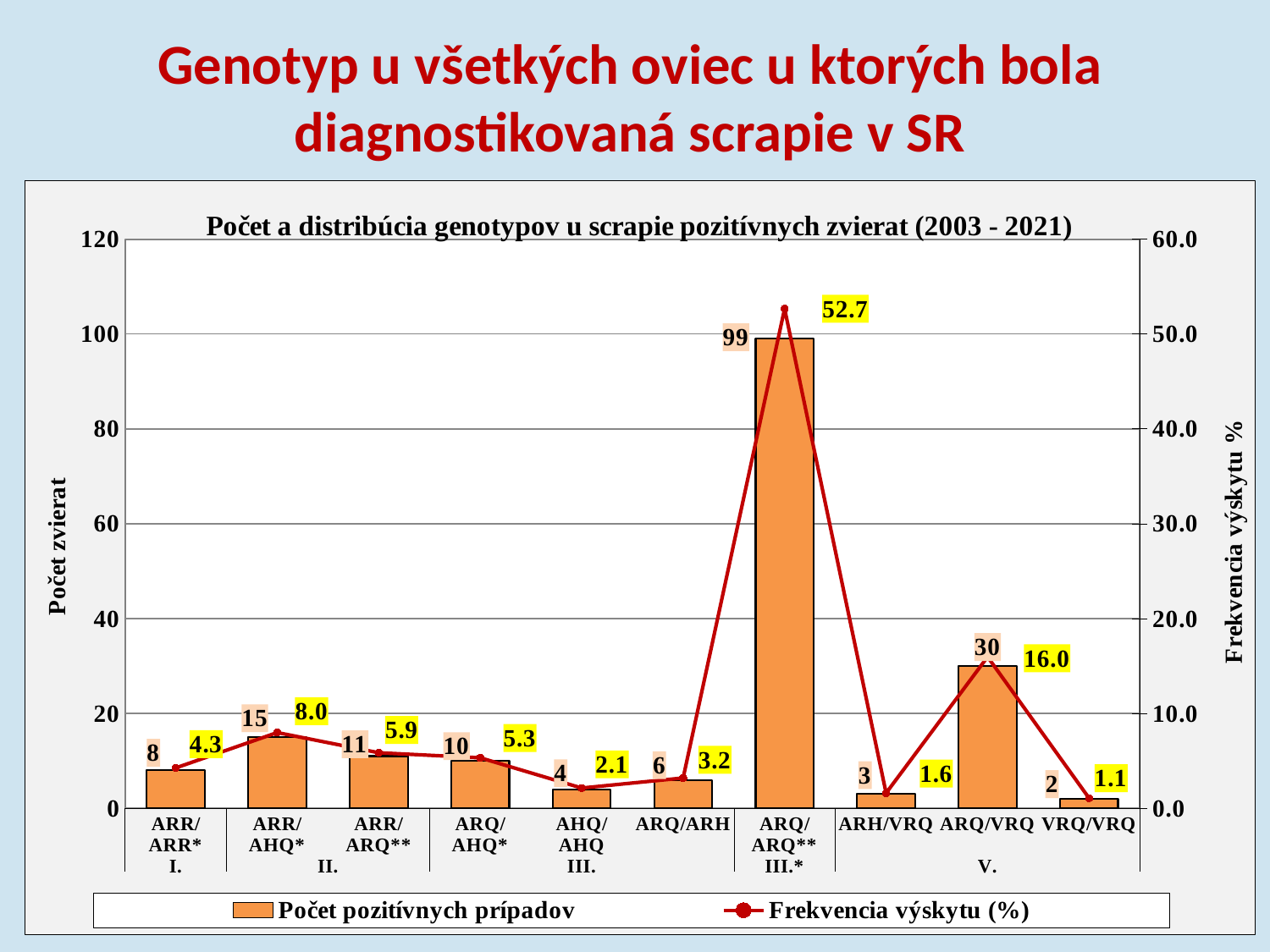
What kind of chart is shown on the slide? Combined bar and line chart What is the number of positive cases (Počet pozitívnych prípadov) for the ARQ/ARQ** genotype? 99 What is the title of the chart? Počet a distribúcia genotypov u scrapie pozitívnych zvierat (2003 - 2021) How many series does the legend list? 2 What is the difference in the number of positive cases between ARQ/ARQ** and ARQ/VRQ? 69 How many genotype categories are shown on the x axis? 10 What is the frequency of occurrence (%) for the AHQ/AHQ genotype? 2.1 Which genotype has the highest number of positive cases? ARQ/ARQ** What is the frequency of occurrence (Frekvencia výskytu %) for the ARQ/VRQ genotype? 16.0 Which genotype has more positive cases, ARR/ARQ** or ARQ/AHQ*? ARR/ARQ** Which genotype has the lowest number of positive cases? VRQ/VRQ What is the number of positive cases for the ARR/AHQ* genotype? 15